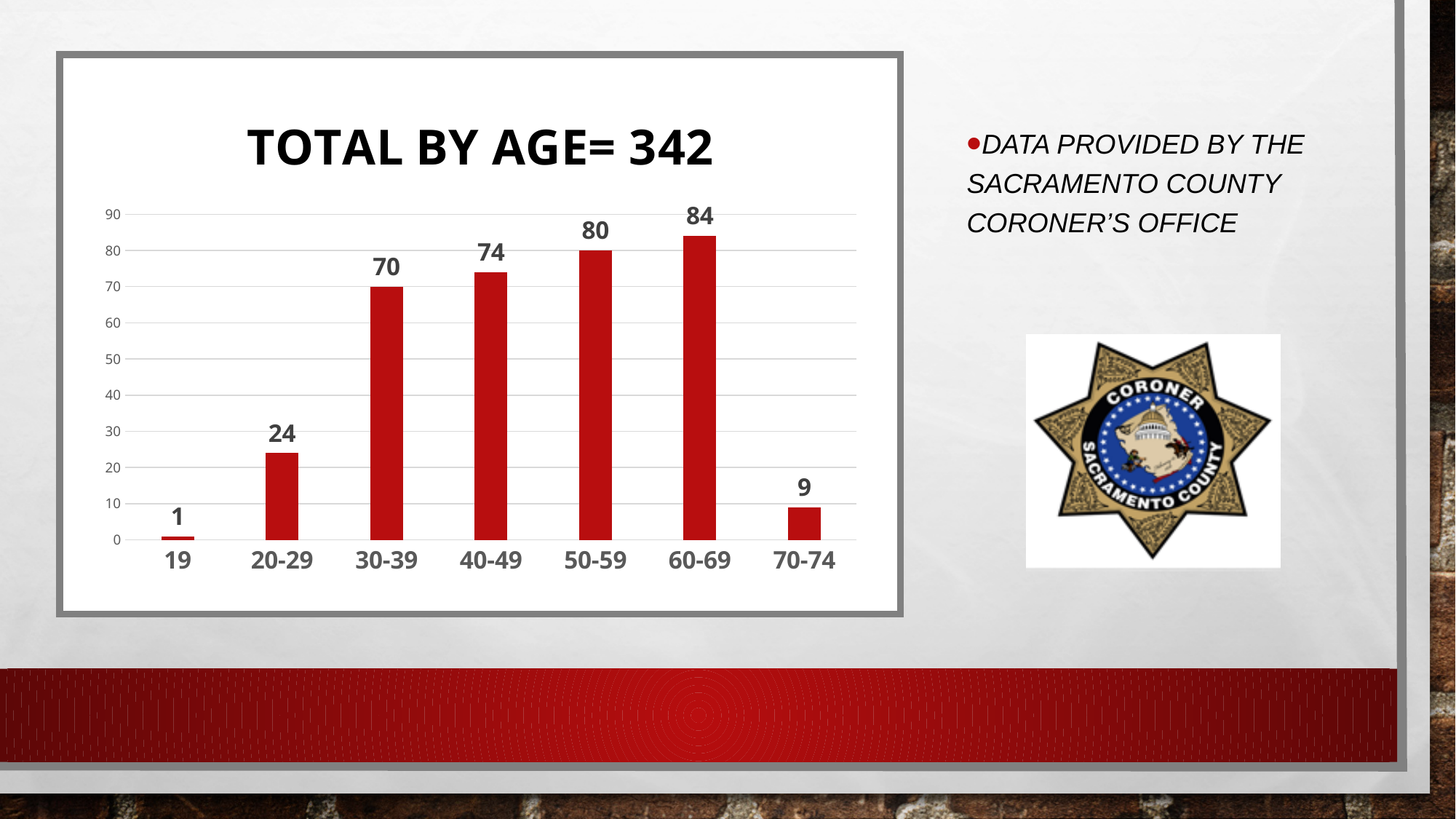
What is the difference between the values for 40-49 and 20-29? 50 What is the title of the chart? TOTAL BY AGE= 342 Which is larger, the value for 40-49 or the value for 30-39? 40-49 What is the value for the 30-39 age group? 70 What is the value for the 70-74 age group? 9 Which age group has the lowest value? 19 Is the value for 50-59 greater or less than 60? greater Which age group has the highest value? 60-69 What is the difference between the values for 60-69 and 50-59? 4 What kind of chart is shown on the slide? bar chart What is the value for the 20-29 age group? 24 How many age groups are shown on the x axis? 7